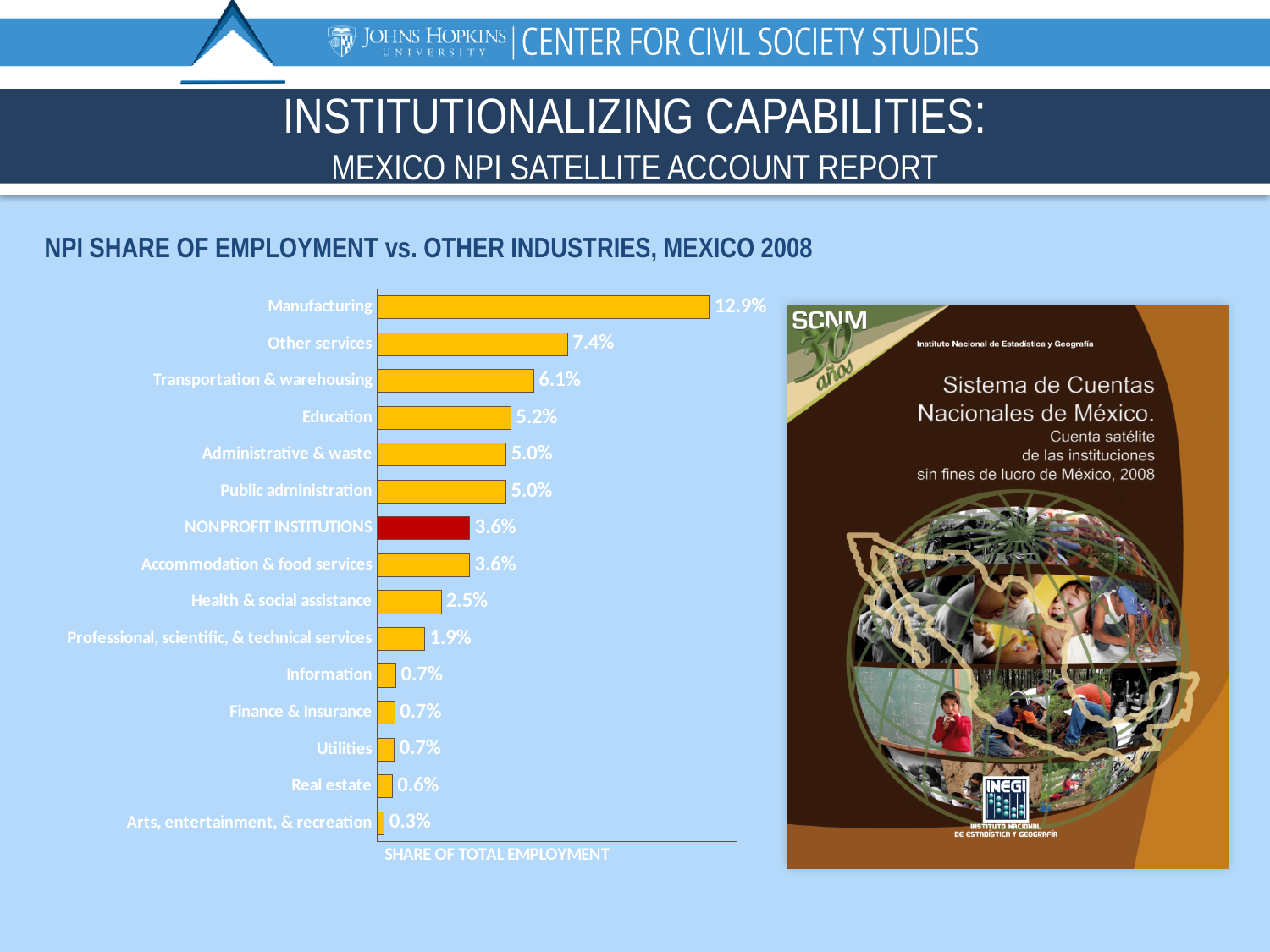
How many categories are shown in the chart? 15 Which bar in the chart is coloured red rather than yellow? Nonprofit Institutions What is the share of total employment for Nonprofit Institutions? 3.6% Which category has the lowest share of total employment? Arts, entertainment, & recreation What is the difference between the shares for Education and Nonprofit Institutions? 1.6% Which category has the highest share of total employment? Manufacturing What is the difference between the shares for Manufacturing and Other services? 5.5% What is the share of total employment for Manufacturing? 12.9% Which has a larger share of total employment, Professional, scientific, & technical services or Real estate? Professional, scientific, & technical services Which has a larger share of total employment, Transportation & warehousing or Education? Transportation & warehousing What kind of chart is shown on the slide? Bar chart What is the share of total employment for Health & social assistance? 2.5%